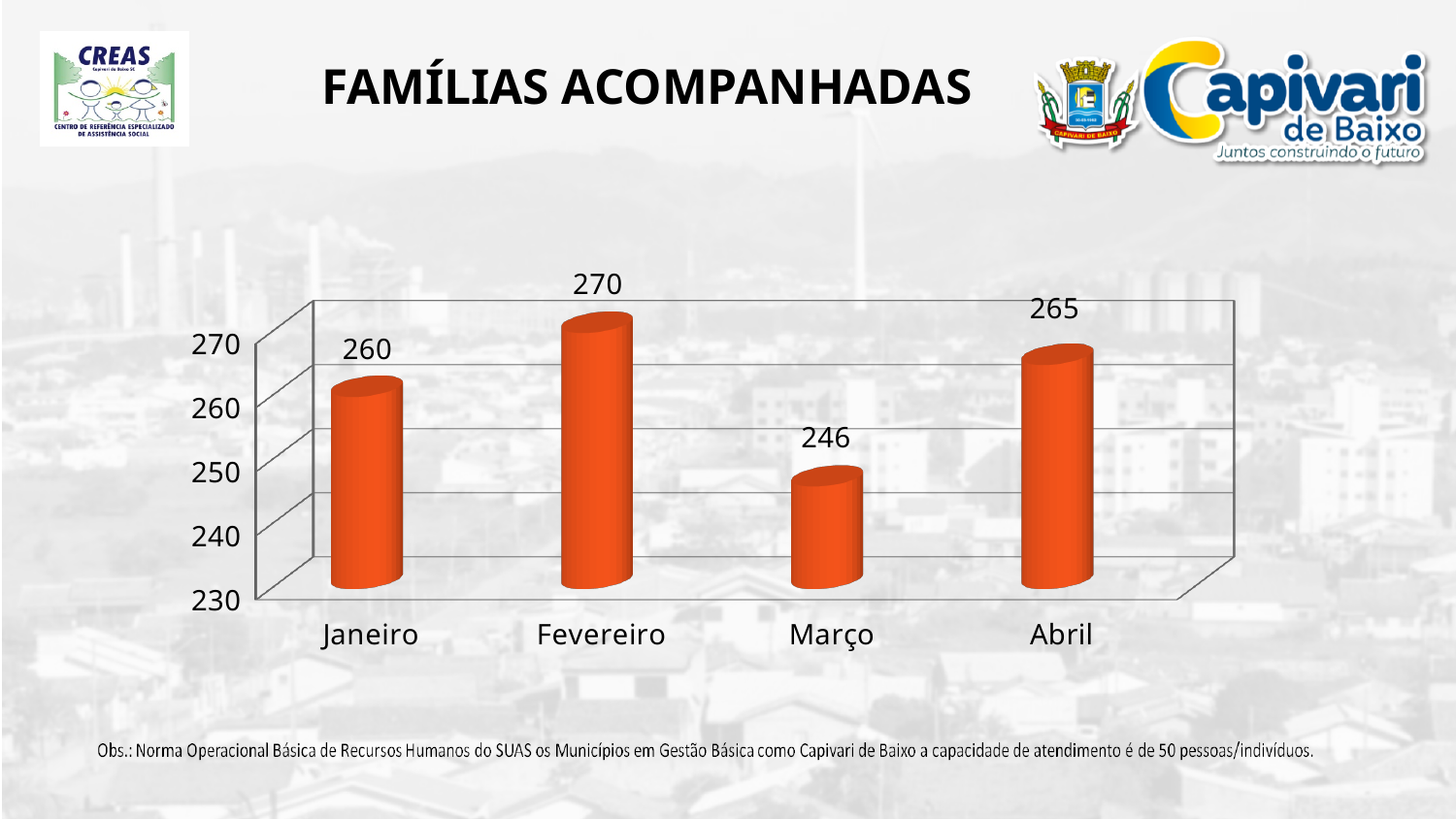
What kind of chart is shown on the slide? bar chart What is the difference between the values for Fevereiro and Março? 24 What is the value for Abril? 265 What is the value for Março? 246 How many months are shown on the chart? 4 What is the title of the chart? FAMÍLIAS ACOMPANHADAS What is the value for Janeiro? 260 What is the value for Fevereiro? 270 Which month has the highest value? Fevereiro Which month has the lowest value? Março Which is larger, the value for Janeiro or the value for Abril? Abril Is the value for Março greater or less than 250? less